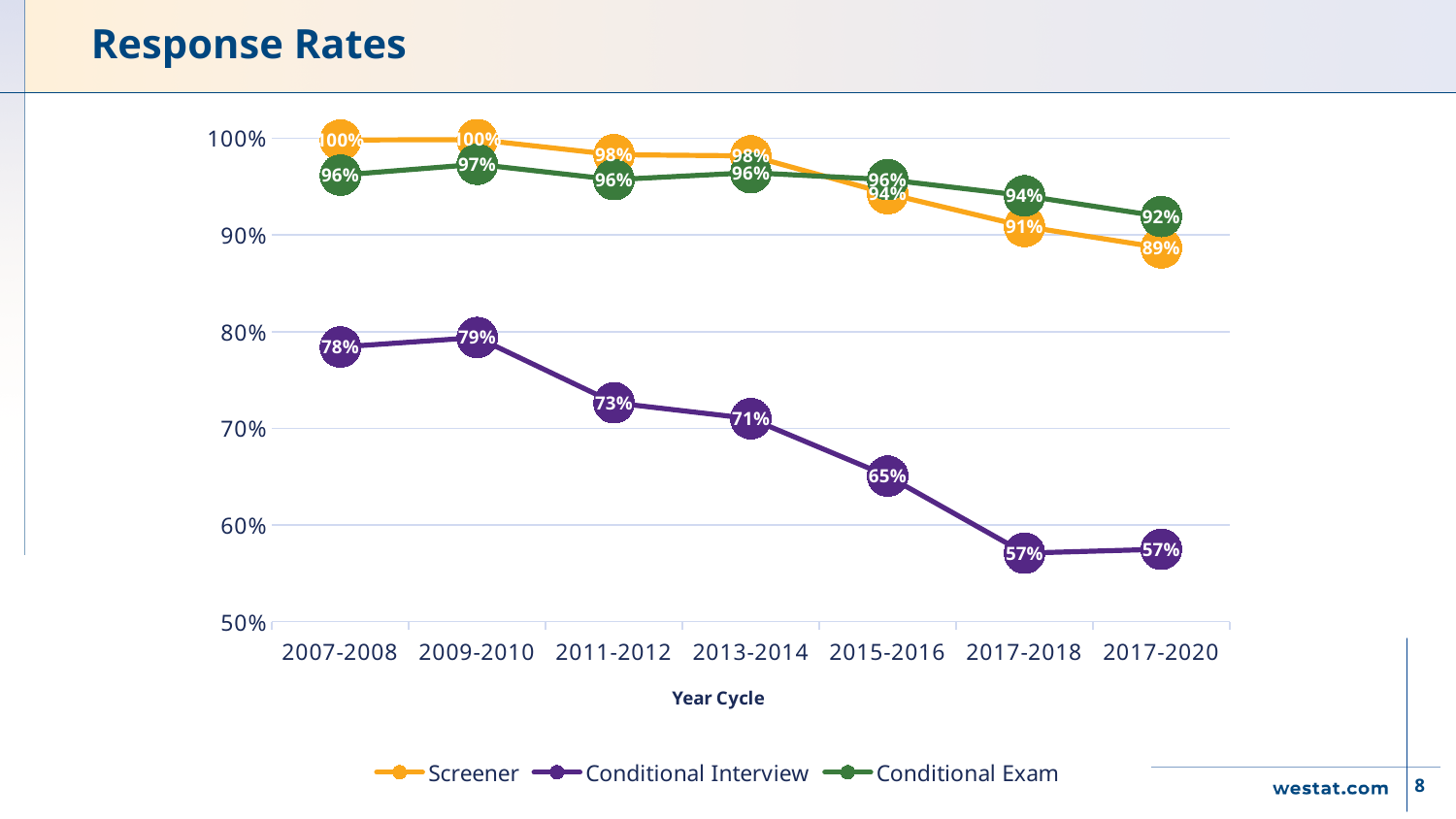
Does the Conditional Interview response rate generally rise or fall across the year cycles? fall What is the difference between the Conditional Interview response rates for 2007-2008 and 2017-2020? 21% What is the Screener response rate for 2017-2018? 91% What is the Conditional Exam response rate for 2017-2020? 92% What is the Conditional Interview response rate for 2015-2016? 65% Is the Conditional Interview response rate for 2017-2018 greater or less than 60%? less Which is larger in 2015-2016, the Screener rate or the Conditional Exam rate? Conditional Exam Which year cycle has the lowest Screener response rate? 2017-2020 How many year cycles are shown on the x axis? 7 What kind of chart is shown on the slide? line chart Which year cycle has the highest Conditional Interview response rate? 2009-2010 How many series does the legend list? 3